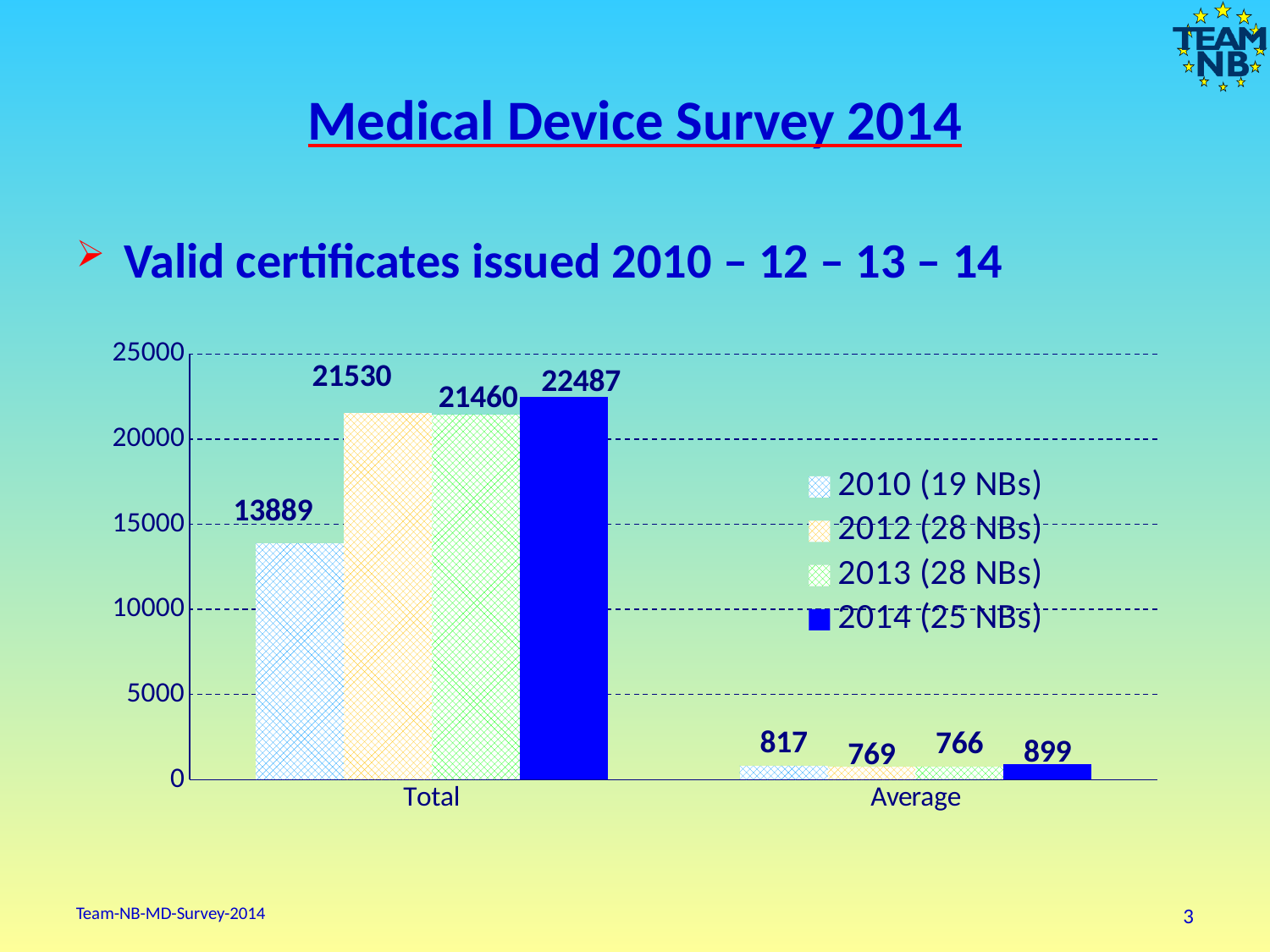
How many series does the legend list? 4 Is the Total value for 2012 (28 NBs) greater or less than 20000? greater What is the Total value for 2010 (19 NBs)? 13889 What is the Average value for 2014 (25 NBs)? 899 How many categories are shown on the x axis? 2 What is the Total value for 2013 (28 NBs)? 21460 Which legend entry is shown in solid blue? 2014 (25 NBs) Which series has the highest Total value? 2014 (25 NBs) What is the difference between the Total values for 2014 (25 NBs) and 2010 (19 NBs)? 8598 Which is larger, the Average value for 2010 (19 NBs) or for 2012 (28 NBs)? 2010 (19 NBs) Which series has the lowest Average value? 2013 (28 NBs) What kind of chart is shown on the slide? bar chart